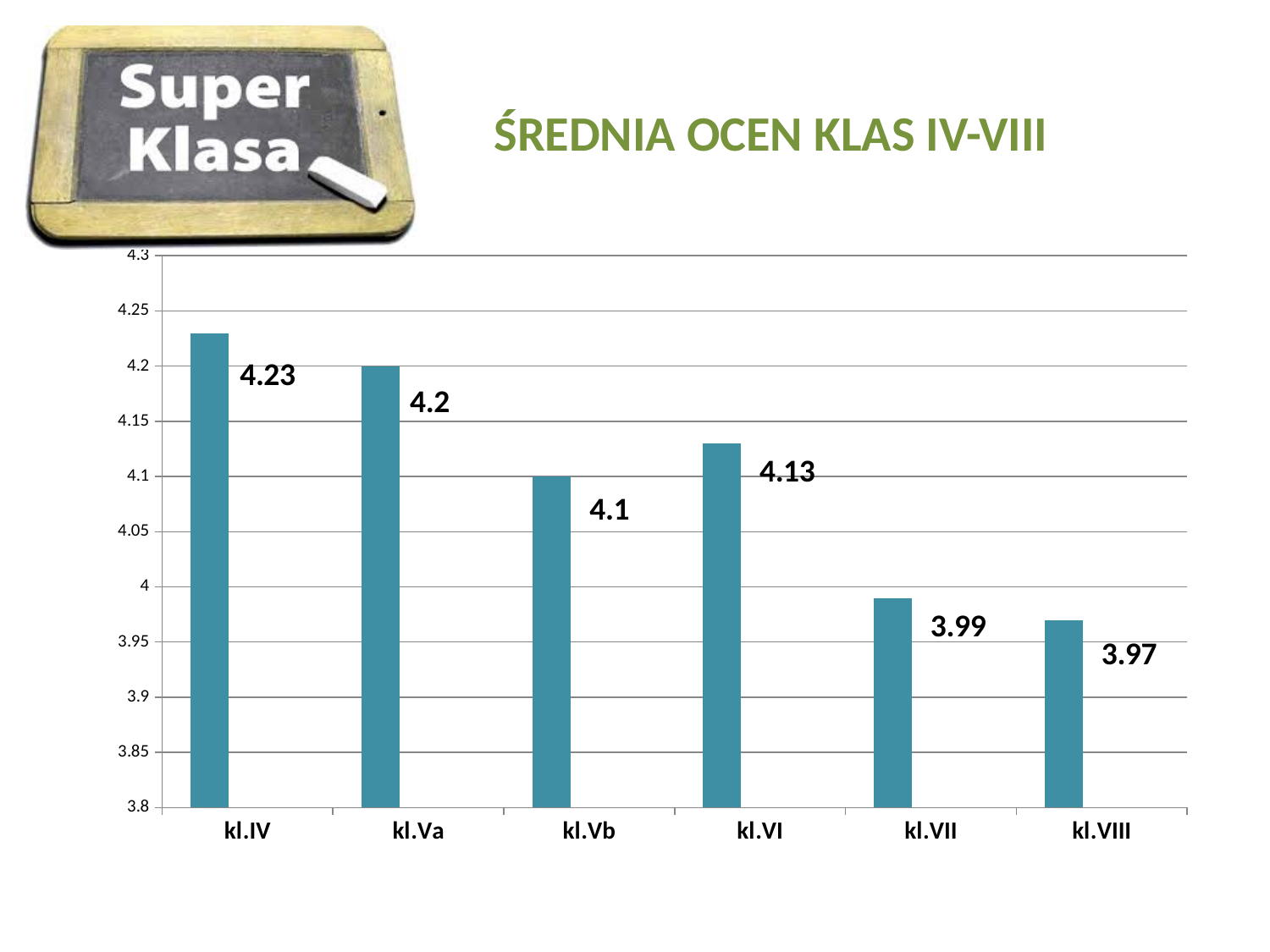
What is the value for kl.IV? 4.23 What is the value for kl.VI? 4.13 Which class has the lowest average? kl.VIII What is the title of the chart? ŚREDNIA OCEN KLAS IV-VIII How many classes are shown on the chart? 6 Which is larger, the value for kl.Vb or the value for kl.VI? kl.VI Is the value for kl.VII greater or less than 4? less What is the value for kl.VIII? 3.97 What is the difference between the values for kl.Va and kl.Vb? 0.1 What is the difference between the values for kl.IV and kl.VIII? 0.26 Which class has the highest average? kl.IV What kind of chart is shown on the slide? bar chart